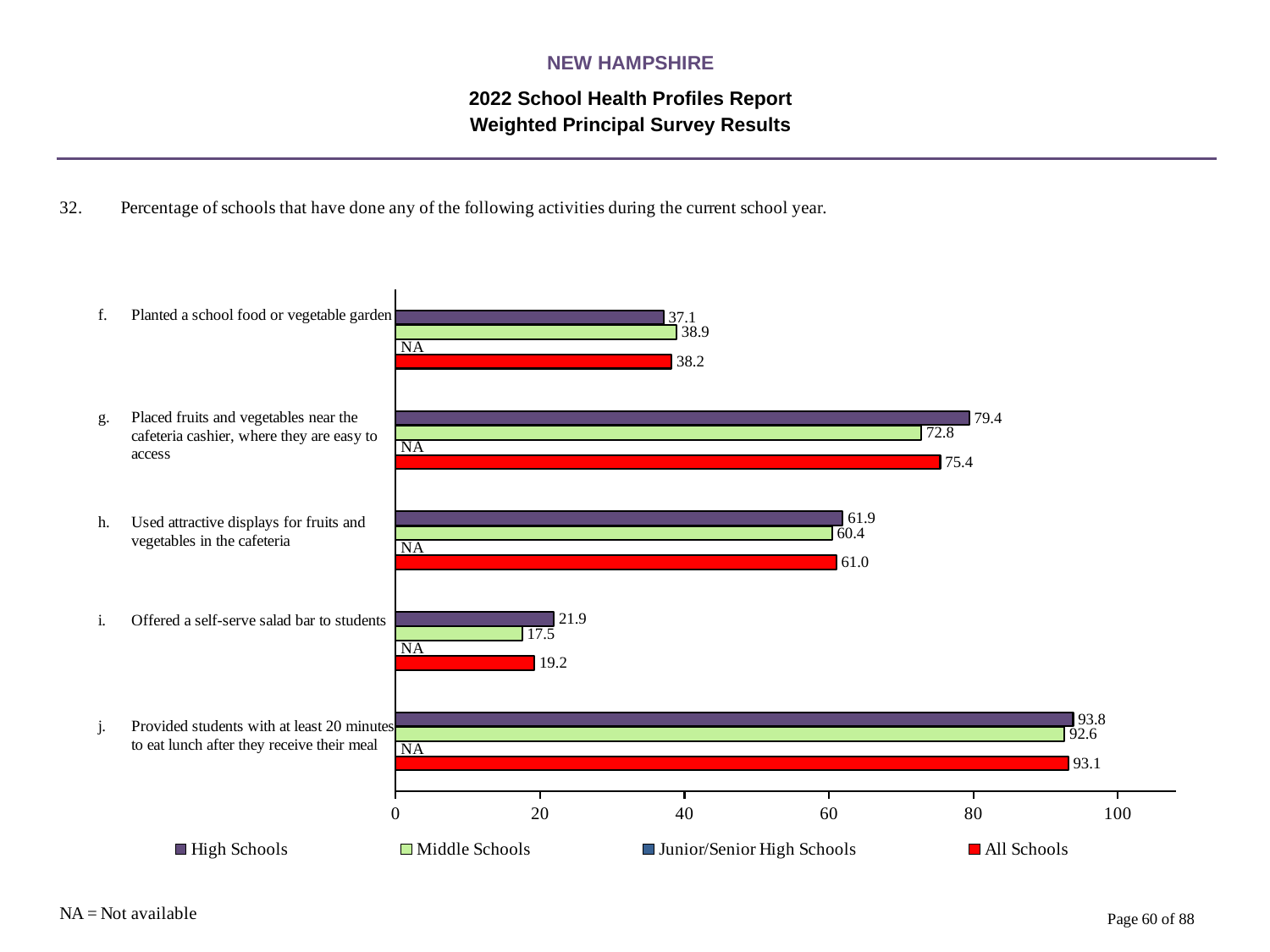
What is the All Schools value for offering a self-serve salad bar to students? 19.2 What value is shown for Junior/Senior High Schools for each activity? NA What percentage of High Schools planted a school food or vegetable garden? 37.1 Which activity has the lowest High Schools percentage? Offered a self-serve salad bar to students Is the All Schools value for placing fruits and vegetables near the cafeteria cashier greater or less than 60? greater What kind of chart is shown on the slide? bar chart Which activity has the highest All Schools percentage? Provided students with at least 20 minutes to eat lunch after they receive their meal What is the Middle Schools value for placing fruits and vegetables near the cafeteria cashier? 72.8 How many activities are listed on the chart? 5 For using attractive displays for fruits and vegetables in the cafeteria, which is larger: the High Schools value or the Middle Schools value? High Schools What is the difference between the High Schools and Middle Schools values for offering a self-serve salad bar? 4.4 How many series does the legend list? 4